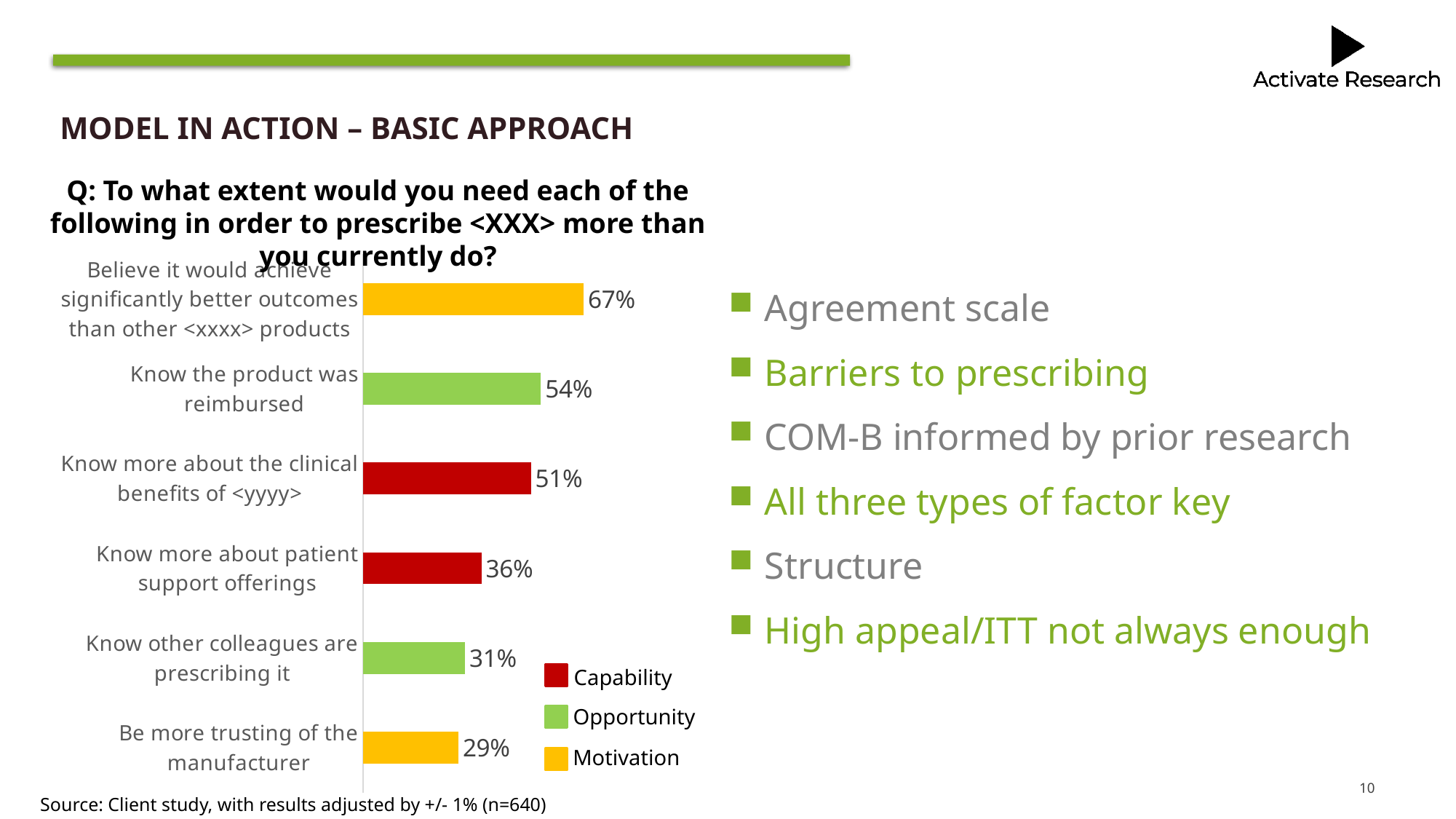
Which legend category does the bar for "Know other colleagues are prescribing it" belong to? Opportunity Which category has the highest value? Believe it would achieve significantly better outcomes than other <xxxx> products What kind of chart is shown on the slide? Bar chart How many entries does the legend list? 3 How many categories are shown in the chart? 6 What is the difference between the values for "Know the product was reimbursed" and "Know other colleagues are prescribing it"? 23% What is the value for "Be more trusting of the manufacturer"? 29% Which is larger: the value for "Know more about the clinical benefits of <yyyy>" or the value for "Know more about patient support offerings"? Know more about the clinical benefits of <yyyy> Which legend entry is shown in red? Capability What is the value for "Know more about patient support offerings"? 36% What is the value for "Know the product was reimbursed"? 54% Which category has the lowest value? Be more trusting of the manufacturer